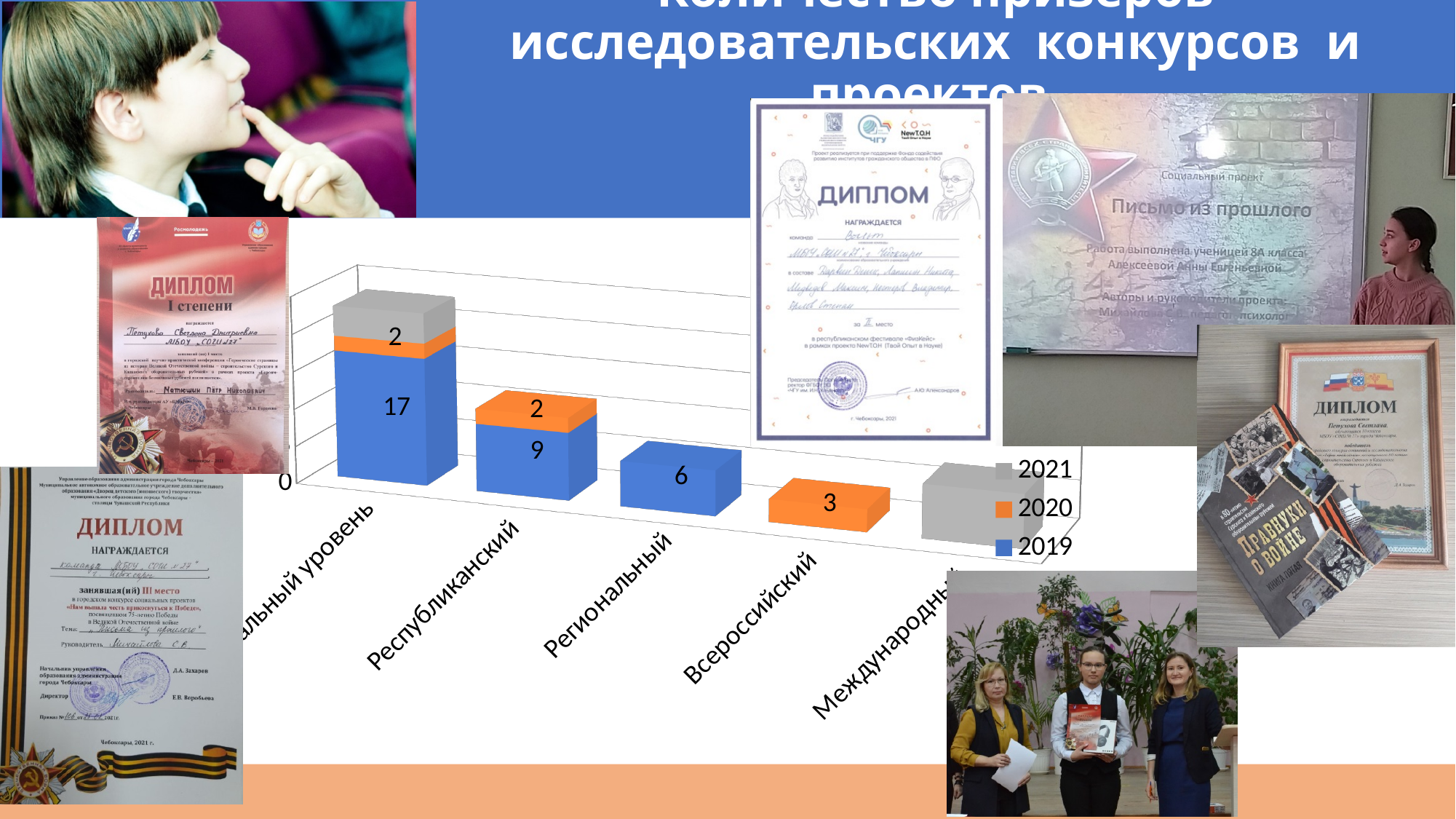
What is the 2020 value for Всероссийский? 3 What colour represents the 2019 series in the chart? blue How many series does the legend list? 3 What is the 2020 value for Республиканский? 2 What is the 2019 value for Республиканский? 9 What is the difference between the 2019 values for Республиканский and Региональный? 3 What entries are listed in the chart legend? 2021, 2020, 2019 Which has the larger 2019 value, Республиканский or Региональный? Республиканский What is the 2019 value for Региональный? 6 How many categories are shown on the x axis of the chart? 5 What kind of chart is shown on the slide? bar chart What is the difference between the 2020 values for Всероссийский and Республиканский? 1